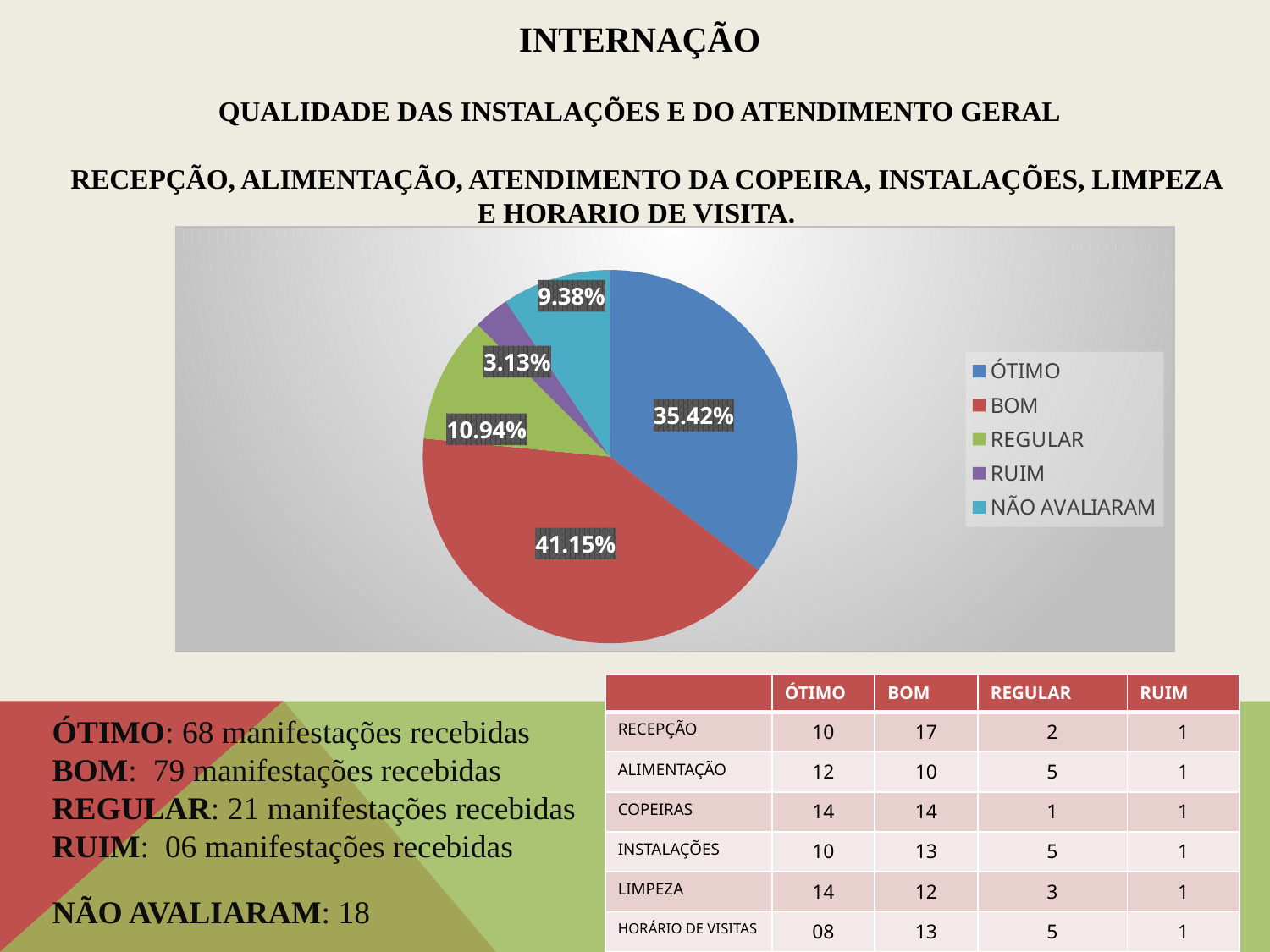
Which category has the largest slice of the pie chart? BOM Which category has the smallest slice of the pie chart? RUIM What is the difference in percentage points between the BOM slice and the ÓTIMO slice? 5.73% What kind of chart is shown on the slide? pie chart What colour is the ÓTIMO slice in the pie chart? blue What percentage of the pie chart is labelled REGULAR? 10.94% What percentage of the pie chart is labelled NÃO AVALIARAM? 9.38% How many slices does the pie chart have? 5 What percentage of the pie chart is labelled RUIM? 3.13% What percentage of the pie chart is labelled ÓTIMO? 35.42% Which slice is larger in the pie chart, REGULAR or NÃO AVALIARAM? REGULAR What percentage of the pie chart is labelled BOM? 41.15%